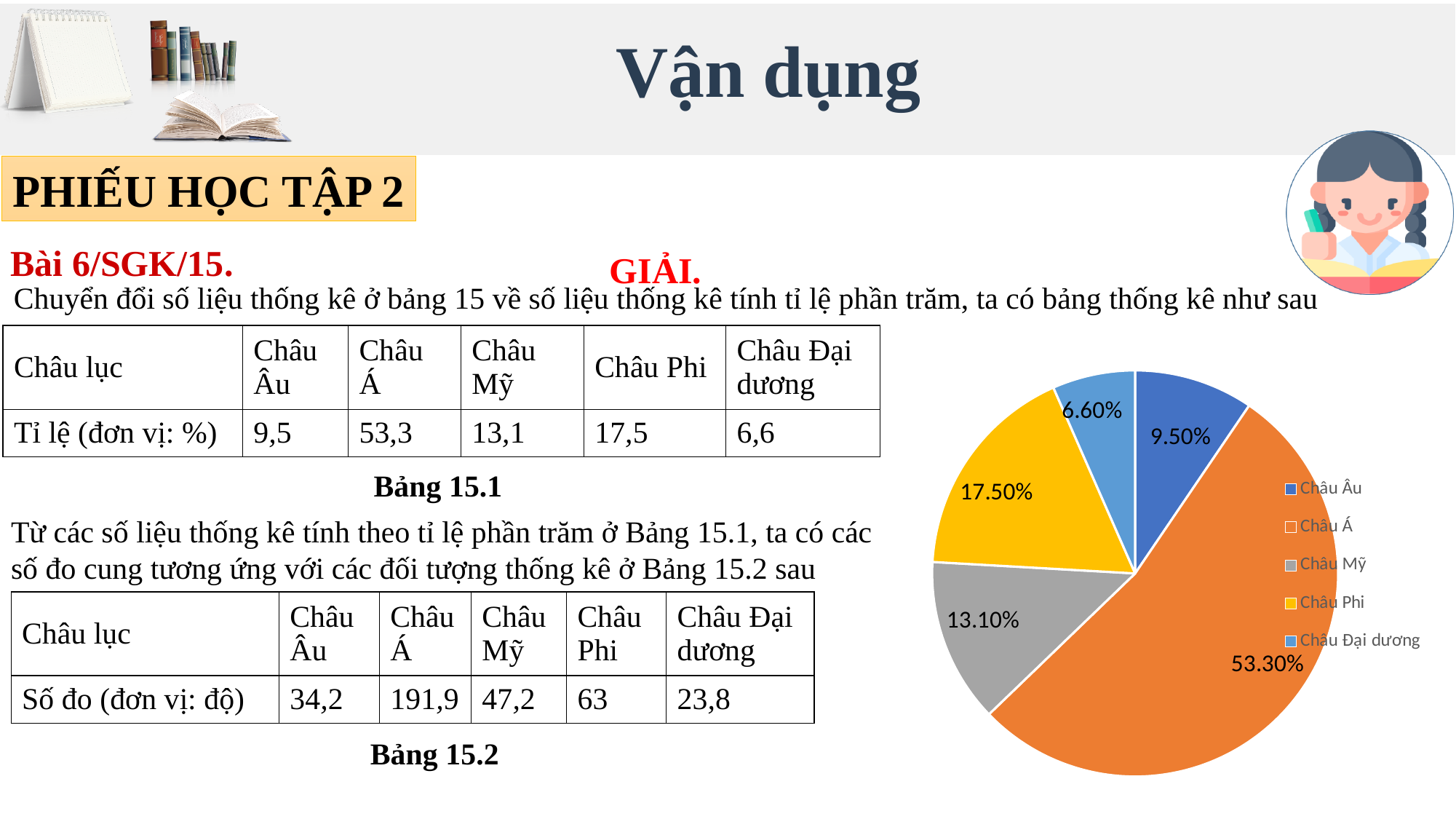
In the pie chart, what is the value shown for Châu Phi? 17.50% In the pie chart, what is the value shown for Châu Á? 53.30% In the pie chart, what is the value shown for Châu Đại dương? 6.60% How many entries does the pie chart's legend list? 5 What colour is the Châu Phi slice in the pie chart? yellow In the pie chart, what is the difference between the values for Châu Phi and Châu Âu? 8.00% Which slice of the pie chart is the largest? Châu Á Which slice of the pie chart is the smallest? Châu Đại dương What kind of chart is shown on the right of the slide? pie chart In the pie chart, which is larger: Châu Phi or Châu Mỹ? Châu Phi In the pie chart, what is the value shown for Châu Mỹ? 13.10% How many slices does the pie chart have? 5